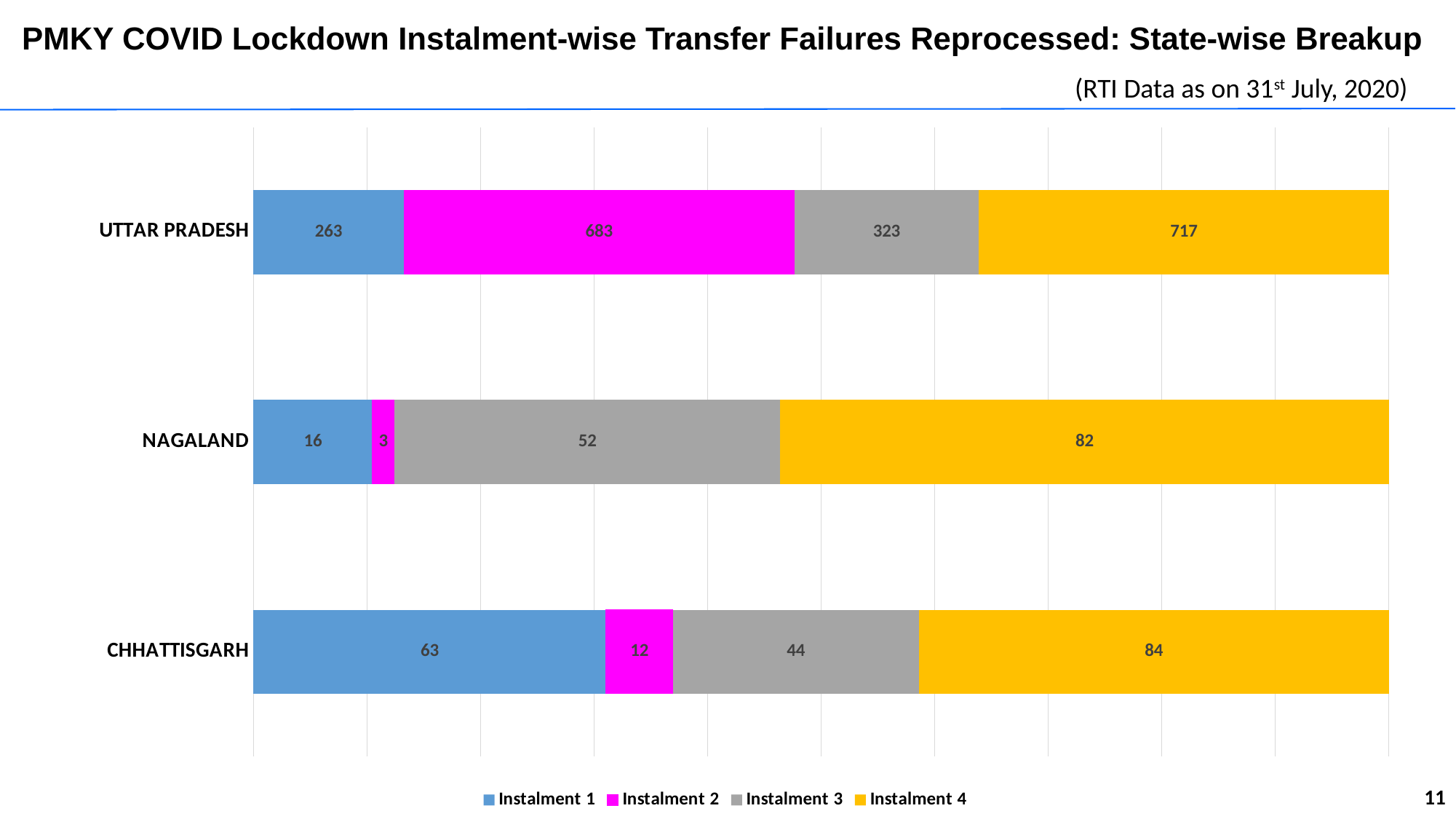
Which state has the lowest Instalment 2 value? Nagaland What is the Instalment 3 value for Nagaland? 52 What is the total of all four instalments for Nagaland? 153 What kind of chart is shown on the slide? Stacked bar chart What is the Instalment 4 value for Nagaland? 82 How many states are shown on the chart? 3 What is the difference between the Instalment 4 and Instalment 1 values for Uttar Pradesh? 454 What is the Instalment 1 value for Chhattisgarh? 63 Which is larger for Chhattisgarh: Instalment 3 or Instalment 4? Instalment 4 Which state has the highest Instalment 4 value? Uttar Pradesh How many series does the legend list? 4 What is the Instalment 2 value for Uttar Pradesh? 683